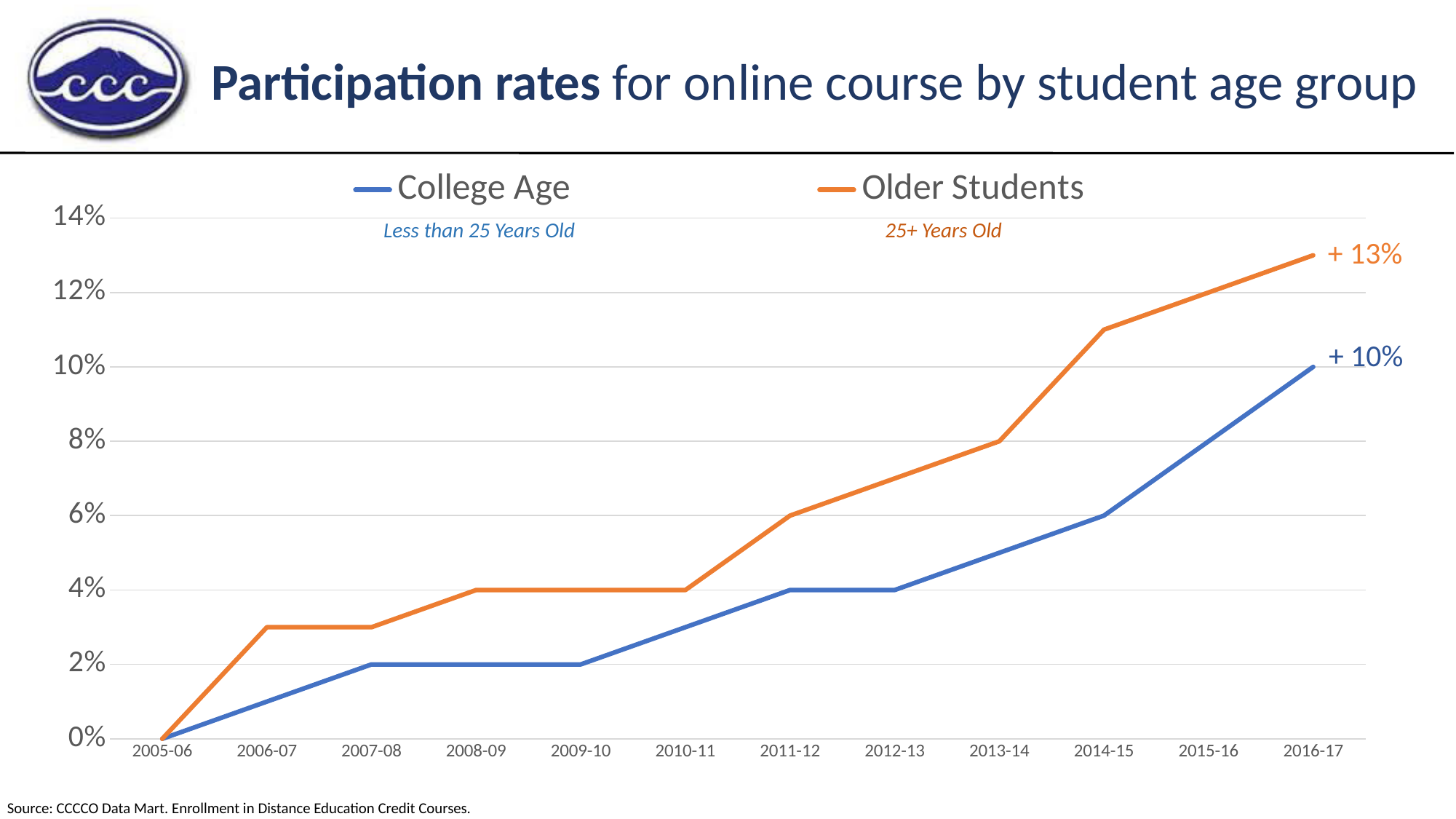
Which series has the higher participation rate in 2014-15, College Age or Older Students? Older Students How many academic years are shown along the x axis? 12 Which age range does the legend give for the College Age series? Less than 25 Years Old What is the participation rate for College Age students in 2014-15? 6% How many series does the legend list? 2 What is the participation rate for College Age students in 2016-17? 10% What is the participation rate for Older Students in 2016-17? 13% Is the participation rate for Older Students in 2014-15 greater or less than 10%? greater What is the difference between the Older Students and College Age participation rates in 2016-17? 3% What kind of chart is shown on the slide? line chart What is the participation rate for Older Students in 2013-14? 8% Does the College Age participation rate rise or fall from 2005-06 to 2016-17? rise